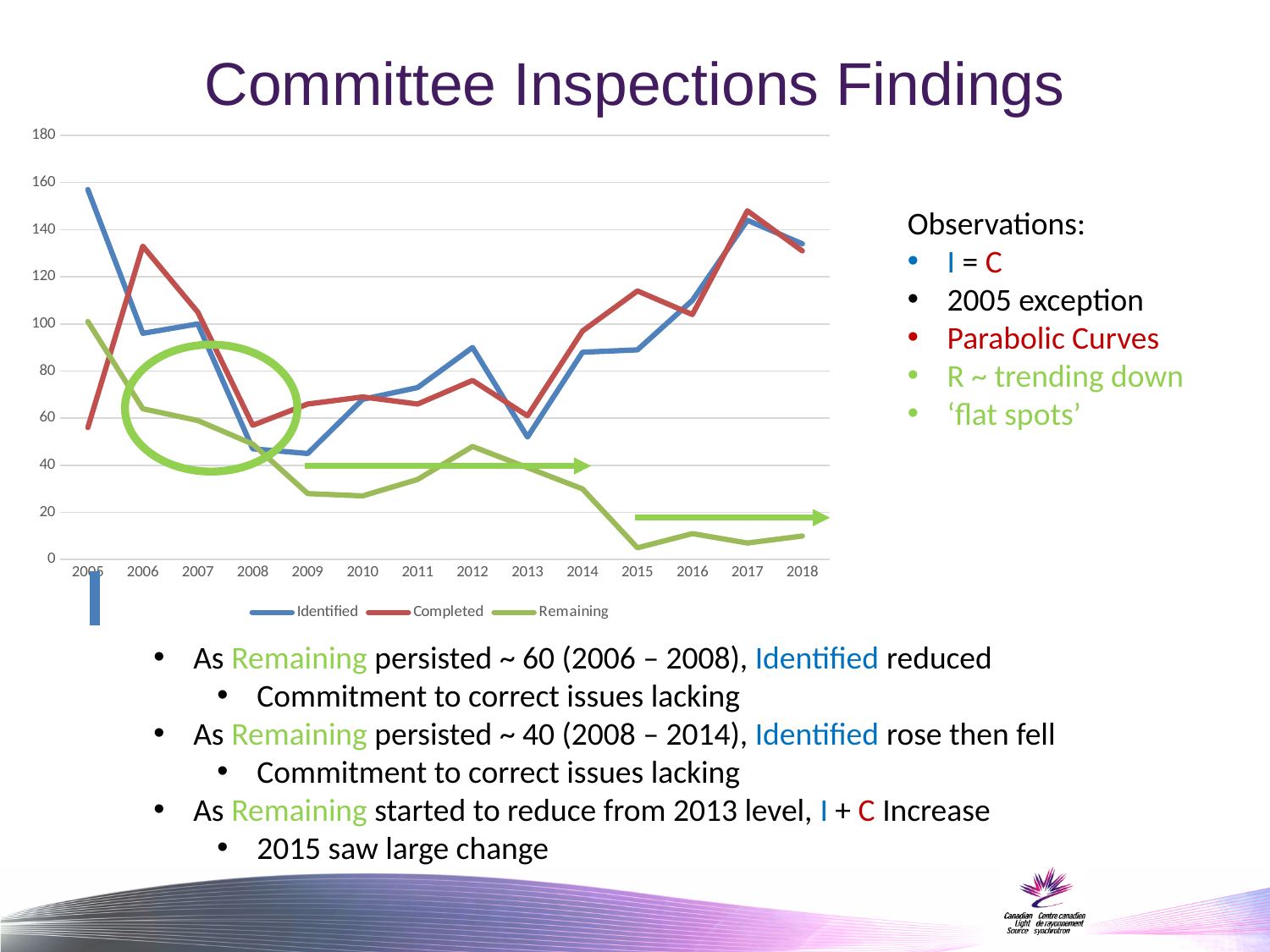
Is the value for Remaining in 2015 greater or less than 20? less What kind of chart is shown on the slide? line chart How many series does the chart legend list? 3 How many years are plotted along the x axis of the chart? 14 In which year does the Identified series reach its highest value? 2005 Is the value for Identified in 2005 greater or less than 140? greater Which series is plotted in green in the chart? Remaining In which year does the Remaining series reach its lowest value? 2015 Is the value for Remaining in 2005 greater or less than 80? greater Does the Remaining series generally rise or fall from 2005 to 2015? fall In which year does the Completed series reach its highest value? 2017 In 2006, which is larger: Identified or Completed? Completed